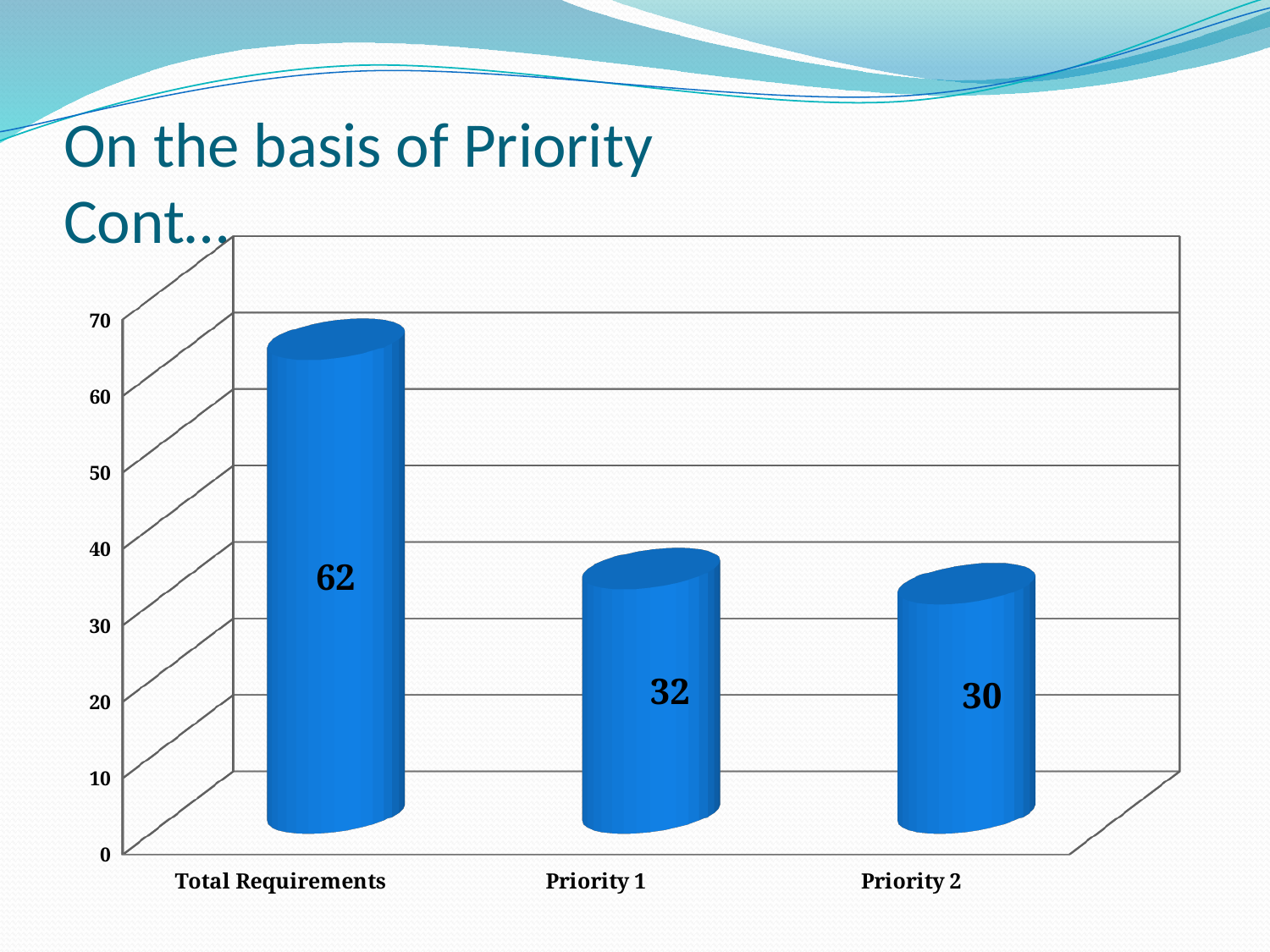
Which is larger, the value for Total Requirements or the value for Priority 1? Total Requirements Which category has the lowest value? Priority 2 What is the value for Priority 2? 30 What is the difference between the values for Priority 1 and Priority 2? 2 Do the values rise or fall from left to right along the x axis? fall What is the value for Priority 1? 32 What kind of chart is shown on the slide? bar chart Is the value for Total Requirements greater or less than 50? greater Which category has the highest value? Total Requirements What is the value for Total Requirements? 62 What is the difference between the values for Total Requirements and Priority 1? 30 How many categories are shown on the x axis? 3